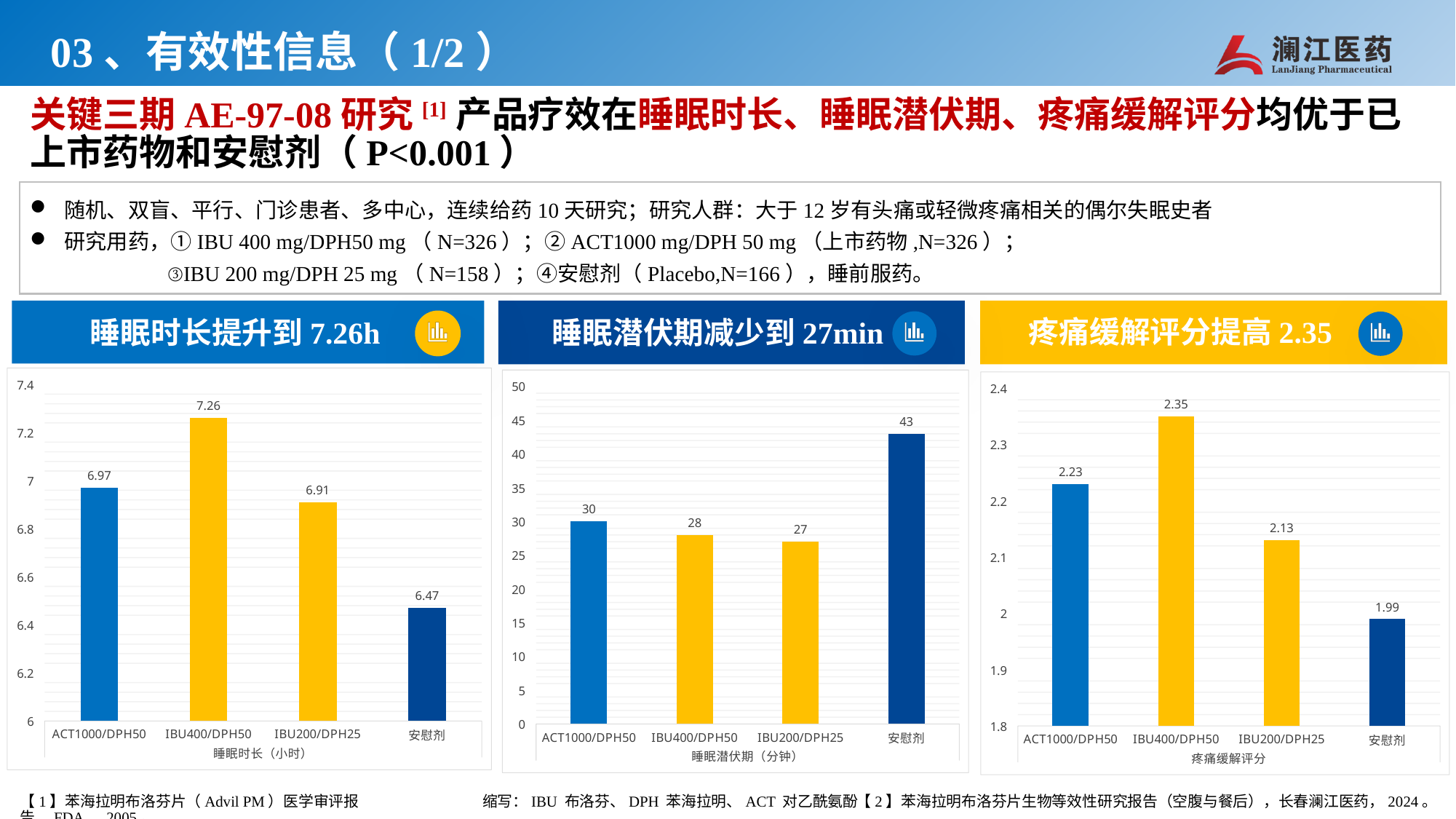
In the middle chart (睡眠潜伏期), what is the value for 安慰剂? 43 In the middle chart (睡眠潜伏期), what is the difference between ACT1000/DPH50 and IBU400/DPH50? 2 In the right chart (疼痛缓解评分), which category has the highest value? IBU400/DPH50 In the left chart (睡眠时长), which category has the lowest value? 安慰剂 In the right chart (疼痛缓解评分), which is larger, the value for IBU200/DPH25 or the value for 安慰剂? IBU200/DPH25 In the middle chart (睡眠潜伏期), which category has the lowest value? IBU200/DPH25 In the right chart (疼痛缓解评分), what is the value for ACT1000/DPH50? 2.23 What kind of chart is the left chart (睡眠时长)? Bar chart In the left chart (睡眠时长), what is the difference between IBU400/DPH50 and 安慰剂? 0.79 What is the x-axis title of the middle chart? 睡眠潜伏期（分钟） In the middle chart (睡眠潜伏期), how many categories are shown on the x axis? 4 In the left chart (睡眠时长), what is the value for IBU400/DPH50? 7.26